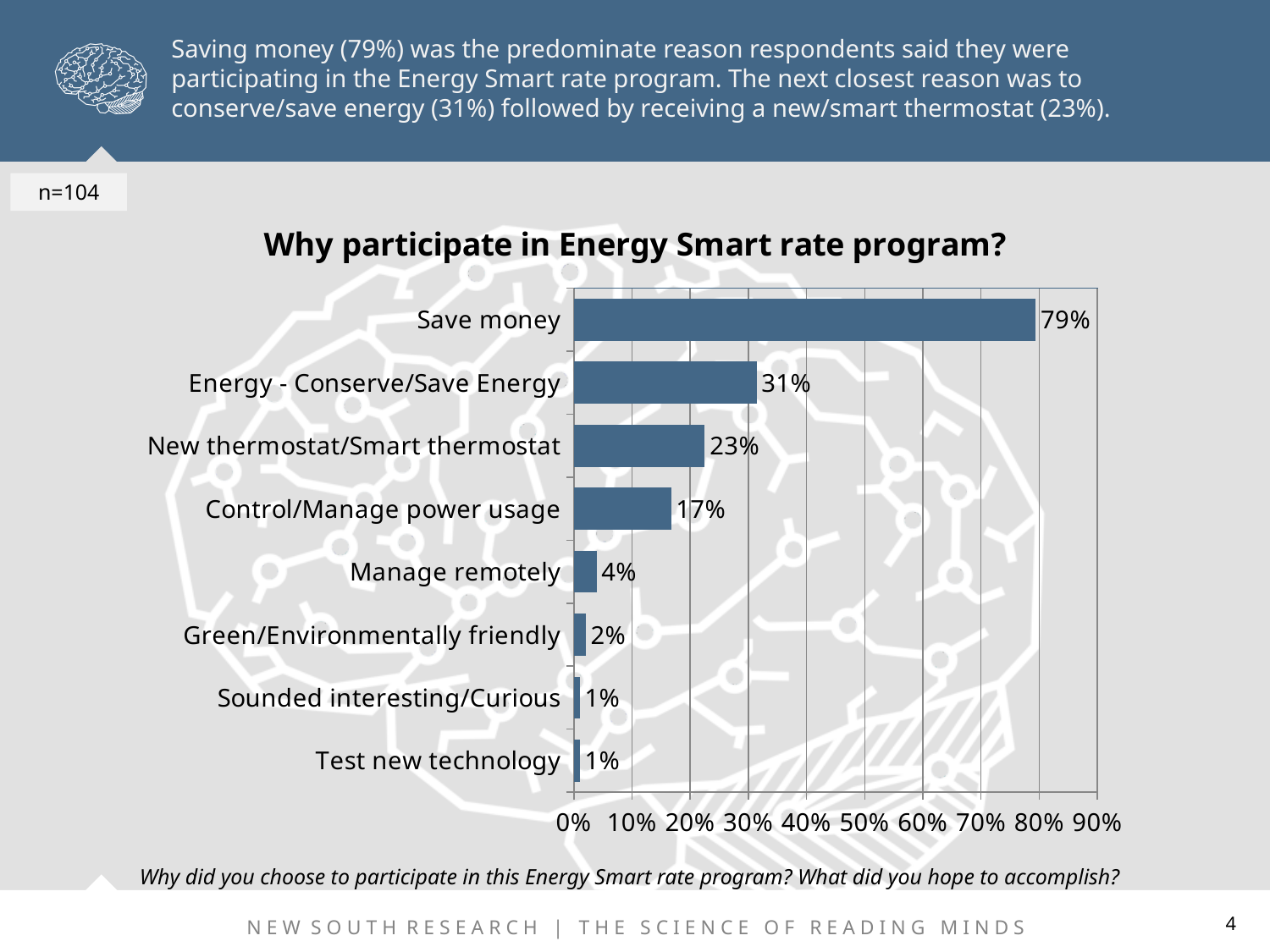
Is the value for Energy - Conserve/Save Energy greater or less than 40%? less What is the title of the chart? Why participate in Energy Smart rate program? What percentage of respondents said they participate to save money? 79% What percentage chose Control/Manage power usage as a reason? 17% What is the difference between New thermostat/Smart thermostat and Control/Manage power usage? 6% Which reason has the highest percentage? Save money What kind of chart is shown on the slide? Bar chart How many reasons are shown in the chart? 8 What is the value for New thermostat/Smart thermostat? 23% Which is larger, Manage remotely or Green/Environmentally friendly? Manage remotely What is the difference between Save money and Energy - Conserve/Save Energy? 48% What is the value for Manage remotely? 4%